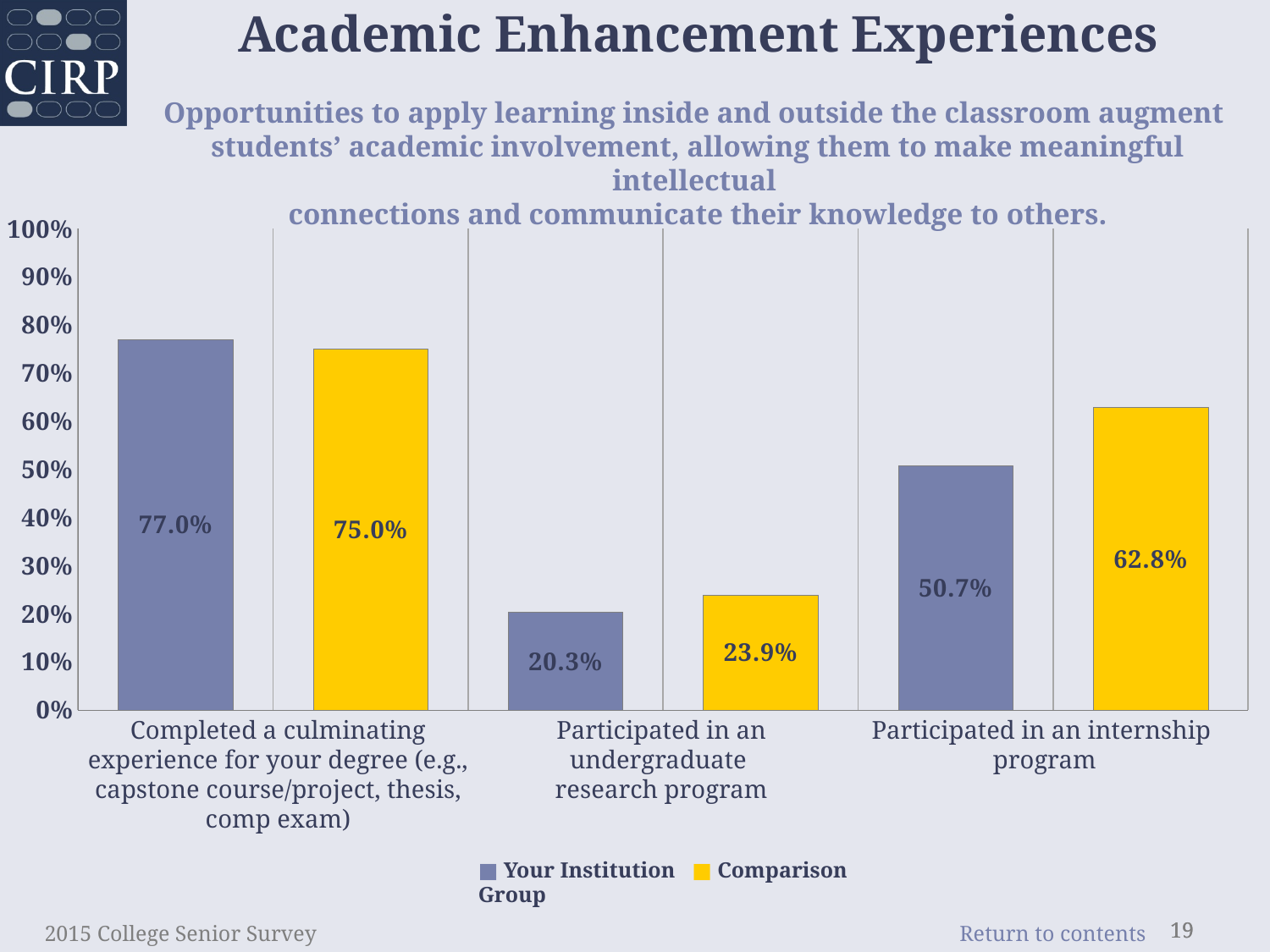
For 'Participated in an undergraduate research program', which is larger: Your Institution or the Comparison Group? Comparison Group What kind of chart is shown on the slide? Bar chart Which category has the highest value for Your Institution? Completed a culminating experience for your degree (e.g., capstone course/project, thesis, comp exam) Which category has the lowest value for the Comparison Group? Participated in an undergraduate research program What is the Comparison Group value for 'Completed a culminating experience for your degree'? 75.0% What is the Comparison Group value for 'Participated in an undergraduate research program'? 23.9% How many series does the legend list? 2 How many categories are shown on the x axis? 3 What is the difference between Your Institution and the Comparison Group for 'Completed a culminating experience for your degree'? 2.0% What is the difference between the Comparison Group and Your Institution values for 'Participated in an internship program'? 12.1% Is the Your Institution value for 'Participated in an internship program' greater or less than 60%? less What is the value for Your Institution for 'Participated in an internship program'? 50.7%